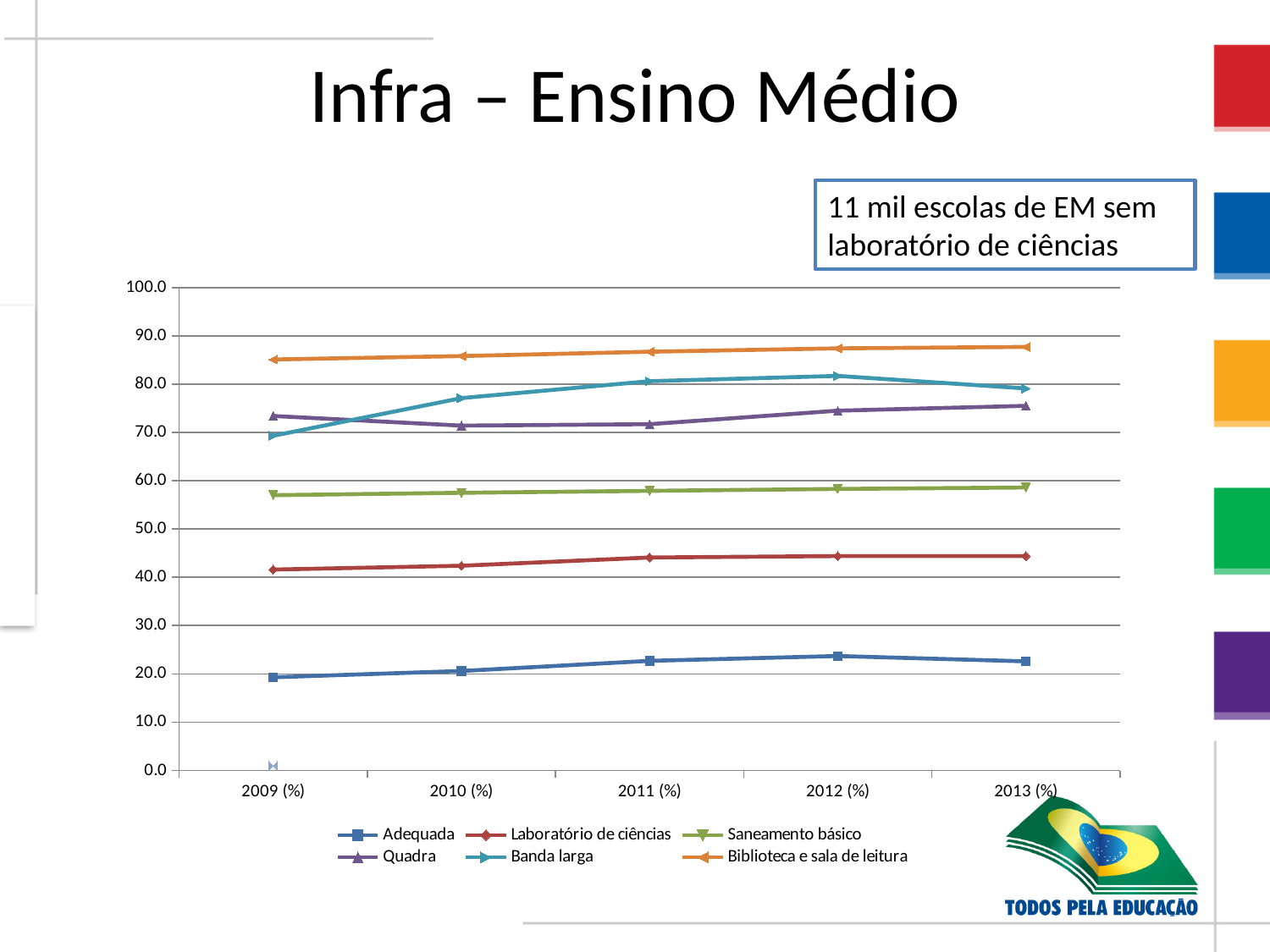
In 2009 (%), which is higher: Quadra or Banda larga? Quadra Is the value for Adequada in 2012 (%) greater or less than 20.0? greater What kind of chart is shown on the slide? line chart How many series does the legend list? 6 Does the Banda larga series rise or fall from 2009 (%) to 2012 (%)? rise Which series has the highest value in 2013 (%)? Biblioteca e sala de leitura Which series has the lowest values across all years? Adequada In 2012 (%), which is higher: Banda larga or Quadra? Banda larga What colour is the line for Biblioteca e sala de leitura? orange How many years are plotted along the x axis? 5 Is the value for Laboratório de ciências in 2013 (%) greater or less than 50.0? less Is the value for Biblioteca e sala de leitura in 2009 (%) greater or less than 80.0? greater